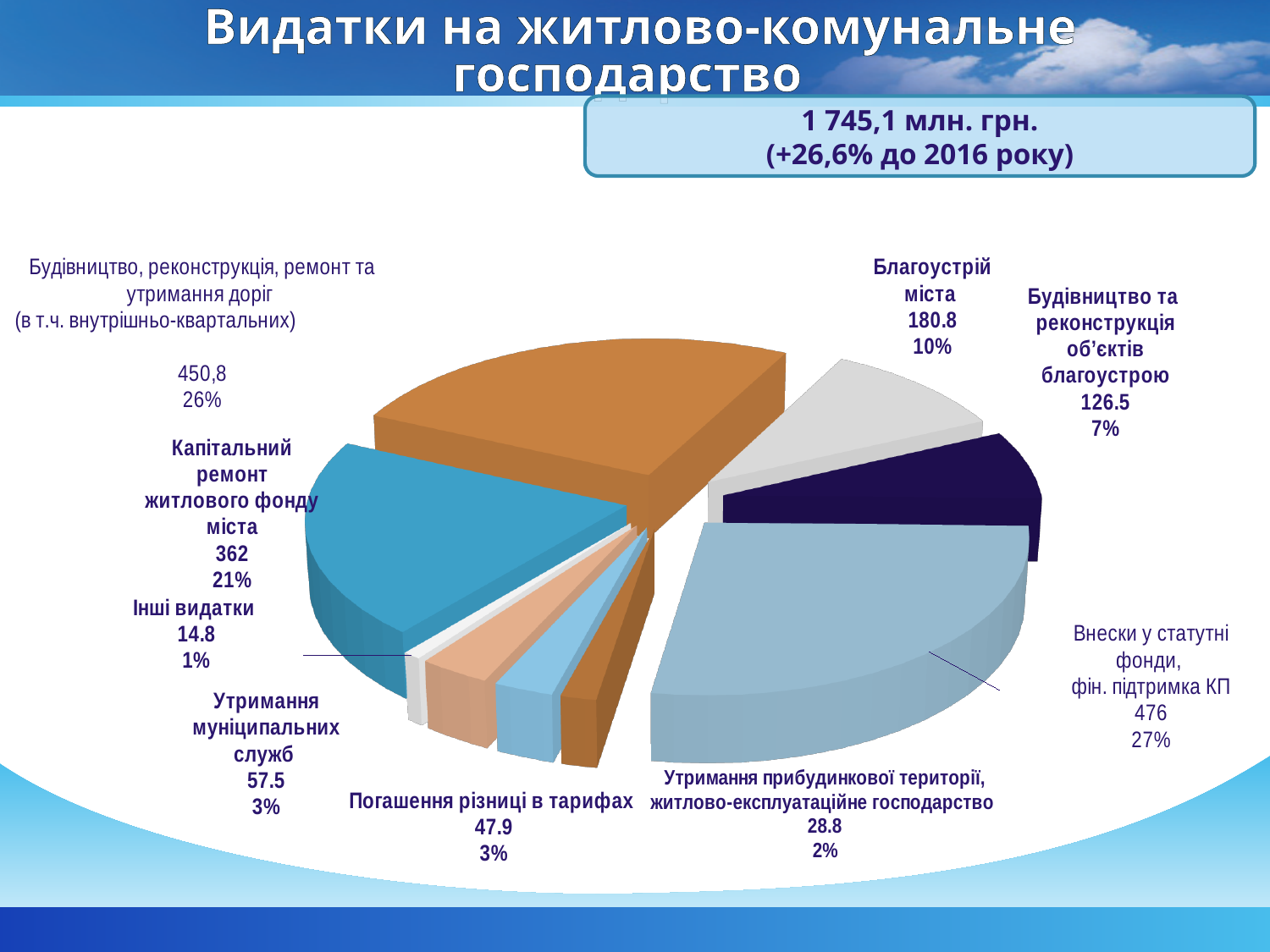
What is the value for "Погашення різниці в тарифах"? 47.9 What kind of chart is shown on the slide? pie chart How many categories (slices) does the pie chart show? 9 What share of the pie does "Будівництво, реконструкція, ремонт та утримання доріг" represent? 26% Which category has the smallest value? Інші видатки Which category has the largest value? Внески у статутні фонди, фін. підтримка КП What is the difference between the values for "Утримання муніципальних служб" and "Утримання прибудинкової території, житлово-експлуатаційне господарство"? 28.7 Which is larger: the value for "Благоустрій міста" or the value for "Будівництво та реконструкція об'єктів благоустрою"? Благоустрій міста What is the value for "Благоустрій міста"? 180.8 What is the title of the slide containing the chart? Видатки на житлово-комунальне господарство What share of the pie does "Будівництво та реконструкція об'єктів благоустрою" represent? 7% What is the value for "Капітальний ремонт житлового фонду міста"? 362